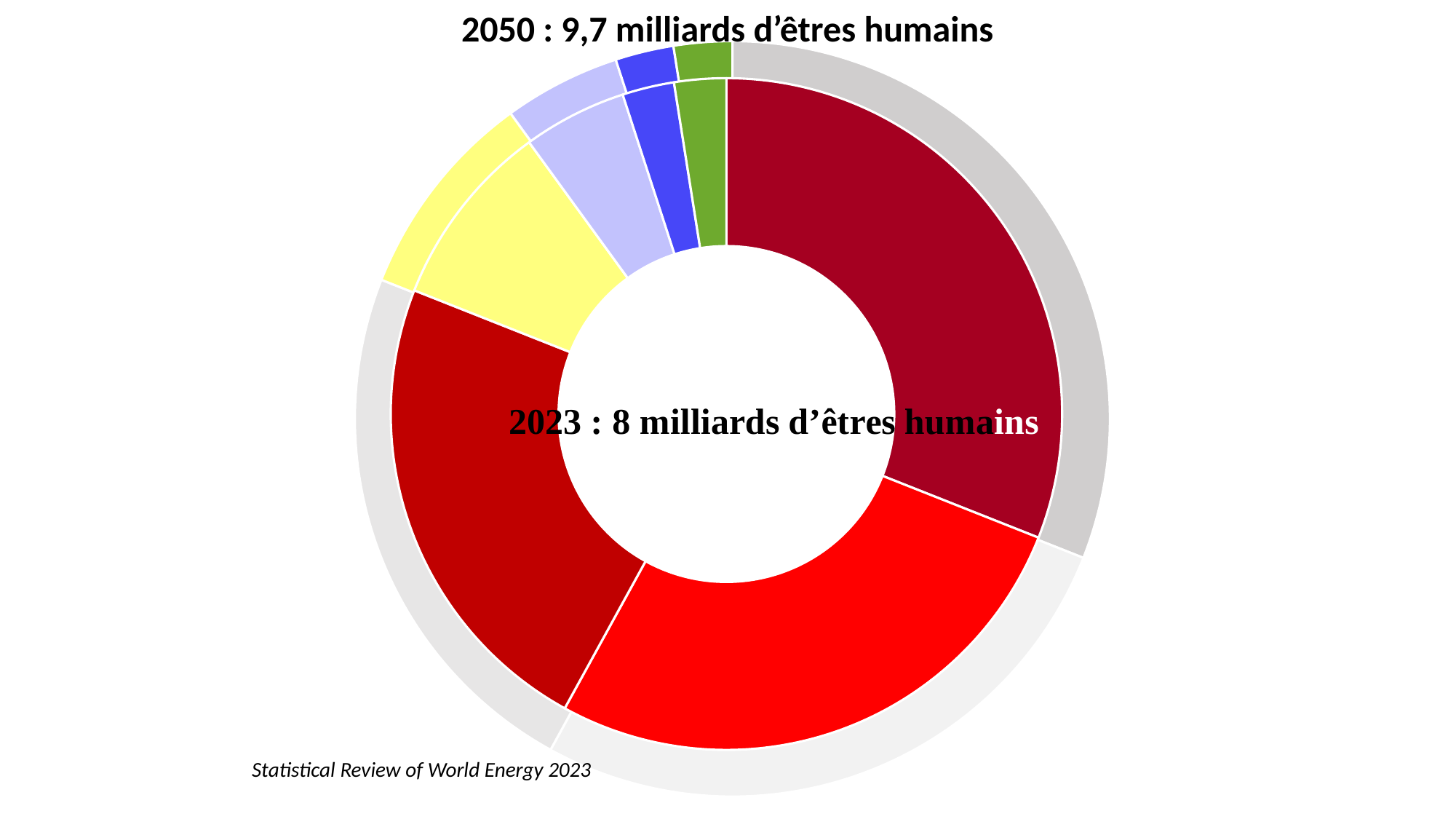
How many slices does the inner ring of the doughnut chart have? 7 What kind of chart is shown on the slide? Doughnut (pie) chart What source is cited at the bottom of the slide? Statistical Review of World Energy 2023 In the inner ring, is the blue slice larger or smaller than the light blue (lavender) slice? Smaller Which colour slice is the largest in the inner ring of the doughnut chart? Dark red In the inner ring, is the bright red slice larger or smaller than the yellow slice? Larger What world population figure does the slide give for 2050? 9,7 milliards d'êtres humains